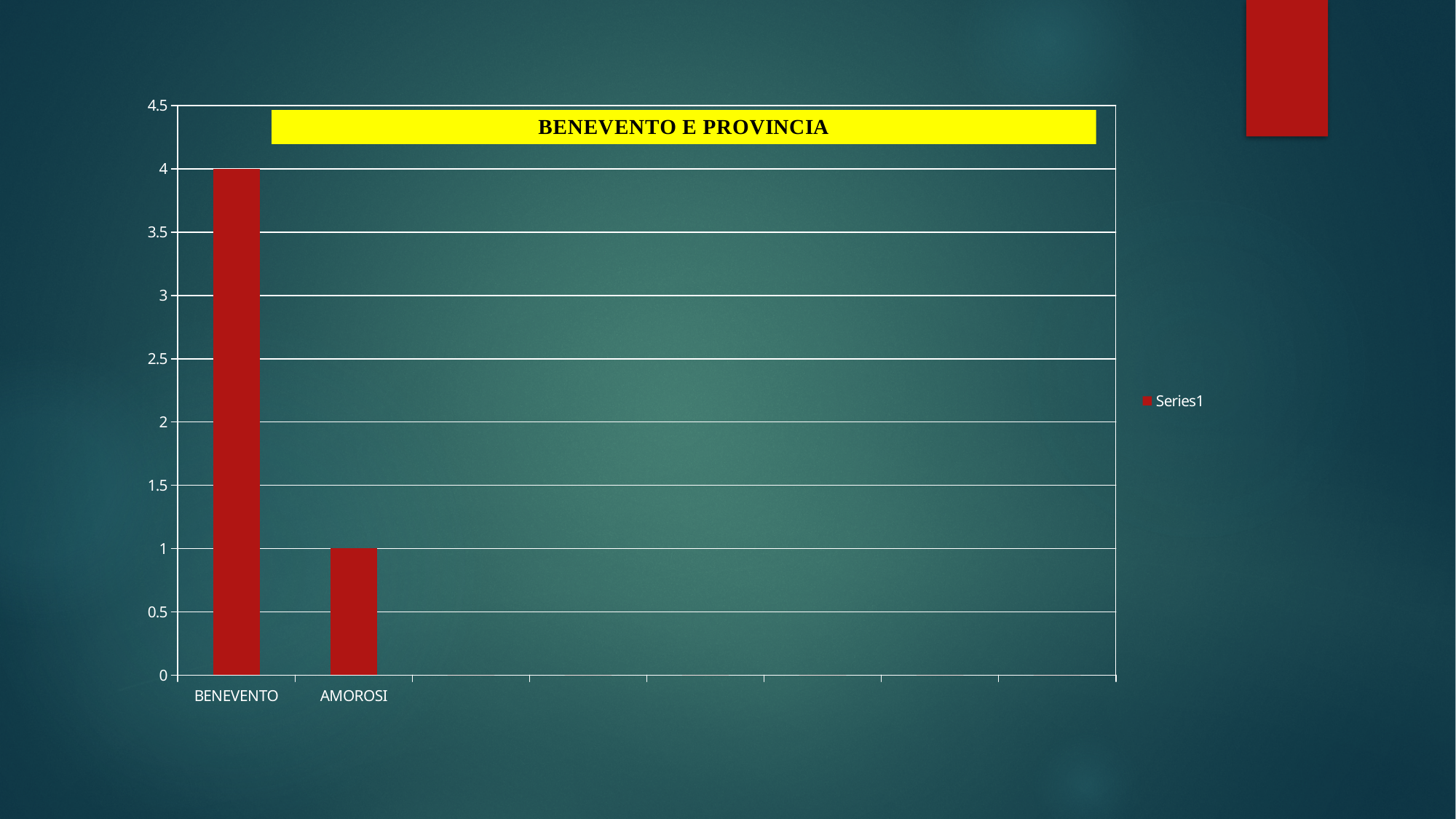
What is the value for BENEVENTO? 4 Is the value for BENEVENTO greater or less than 3? greater What is the difference between the values for BENEVENTO and AMOROSI? 3 What is the title of the chart? BENEVENTO E PROVINCIA What is the value for AMOROSI? 1 Which is larger, the value for BENEVENTO or the value for AMOROSI? BENEVENTO How many bars are plotted in the chart? 2 Which category has the highest value? BENEVENTO How many series does the legend list? 1 Which category has the lowest value? AMOROSI What type of chart is shown on the slide? bar chart Is the value for AMOROSI greater or less than 2? less